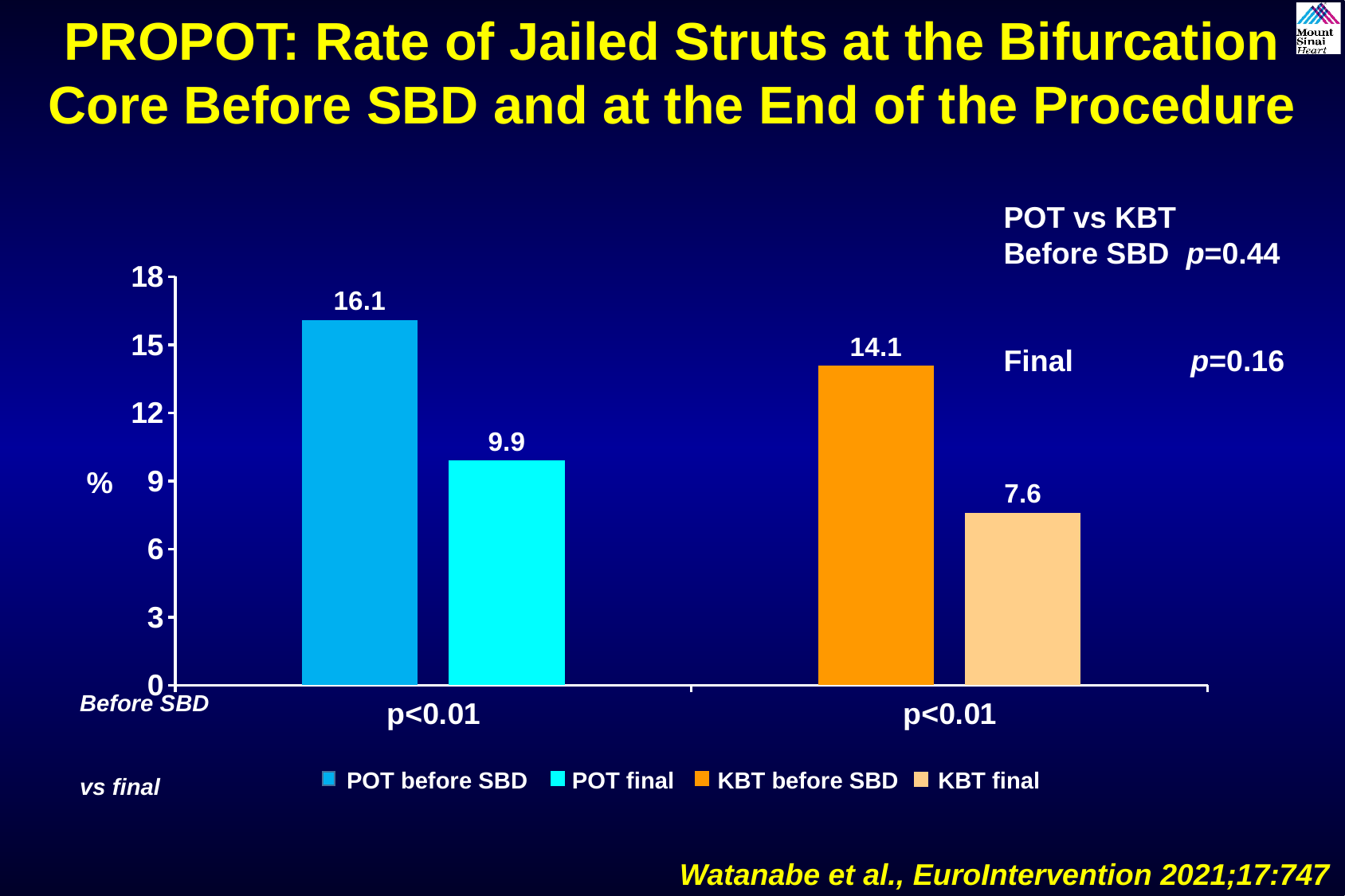
What is the difference between POT before SBD and POT final? 6.2 What kind of chart is shown? Bar chart What is the value for POT final? 9.9 Which is larger, POT final or KBT final? POT final What is the p-value for POT vs KBT before SBD? p=0.44 Which bar has the highest value? POT before SBD What is the difference between KBT before SBD and KBT final? 6.5 What is the value for KBT final? 7.6 Which bar has the lowest value? KBT final What is the value for POT before SBD? 16.1 What is the value for KBT before SBD? 14.1 How many series does the legend list? 4